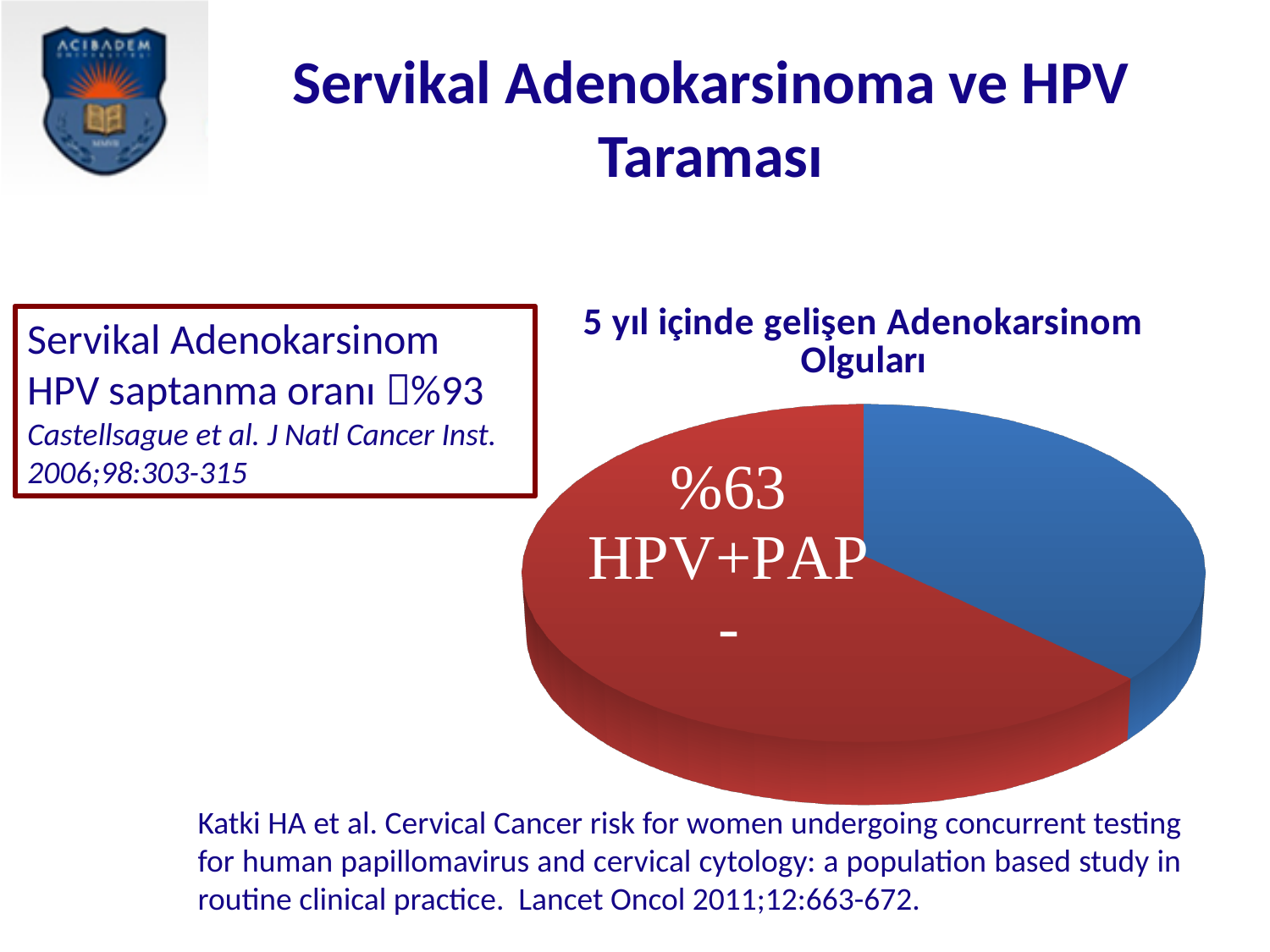
What is the title of the pie chart? 5 yıl içinde gelişen Adenokarsinom Olguları What kind of chart is shown on the slide? pie chart What share of the pie does the HPV+PAP- slice represent? %63 Which slice of the pie chart is larger, the red slice or the blue slice? the red slice What percentage is shown on the HPV+PAP- slice of the pie chart? %63 How many slices does the pie chart have? 2 Which slice of the pie chart is the largest? HPV+PAP- What colour is the slice labelled HPV+PAP- in the pie chart? red